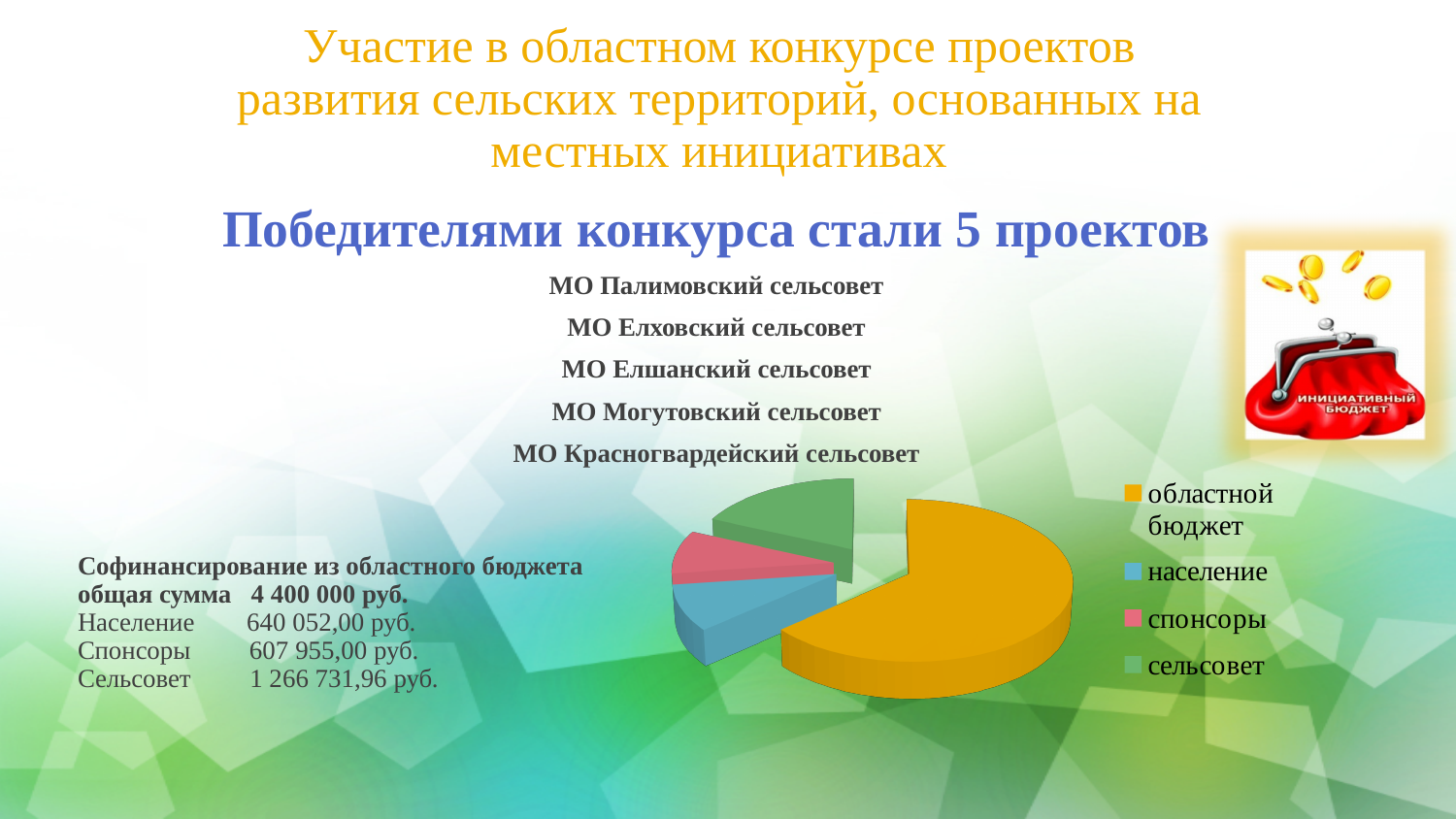
Which slice is larger in the pie chart: сельсовет or население? сельсовет According to the slide, what is the amount for Спонсоры? 607 955,00 руб. Which category has the largest slice in the pie chart? областной бюджет What is the difference between the amounts for Сельсовет and Население shown on the slide? 626 679,96 руб. According to the slide, what is the amount for Население? 640 052,00 руб. According to the slide, what is the total co-financing amount from the областной бюджет? 4 400 000 руб. What colour is the областной бюджет slice in the pie chart? orange According to the slide, what is the amount for Сельсовет? 1 266 731,96 руб. How many entries does the legend of the pie chart list? 4 Which slice is larger in the pie chart: областной бюджет or сельсовет? областной бюджет How many slices does the pie chart have? 4 What kind of chart is shown on the slide? pie chart